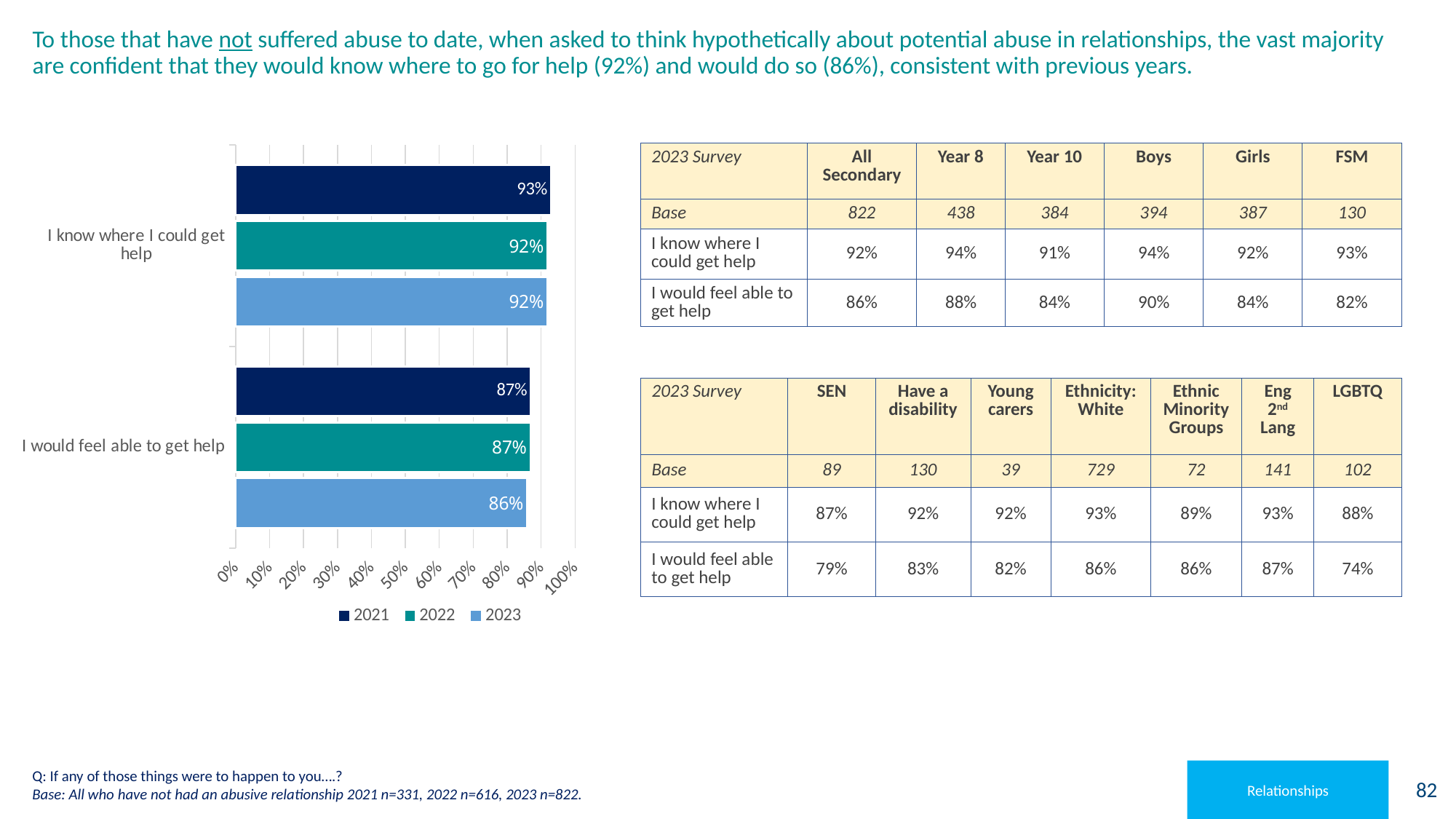
What is the difference between the 2021 and 2023 values for 'I know where I could get help'? 1% How many series does the chart legend list? 3 What is the difference between the 2023 values for 'I know where I could get help' and 'I would feel able to get help'? 6% What is the 2021 value for 'I know where I could get help'? 93% Which category has the higher 2021 value: 'I know where I could get help' or 'I would feel able to get help'? I know where I could get help What is the 2023 value for 'I would feel able to get help'? 86% What is the 2023 value for 'I know where I could get help'? 92% Which years are listed in the chart legend? 2021, 2022, 2023 Is the 2023 value for 'I would feel able to get help' greater or less than 80%? greater How many categories are shown on the chart's vertical axis? 2 What kind of chart is shown on the slide? bar chart What is the 2022 value for 'I would feel able to get help'? 87%